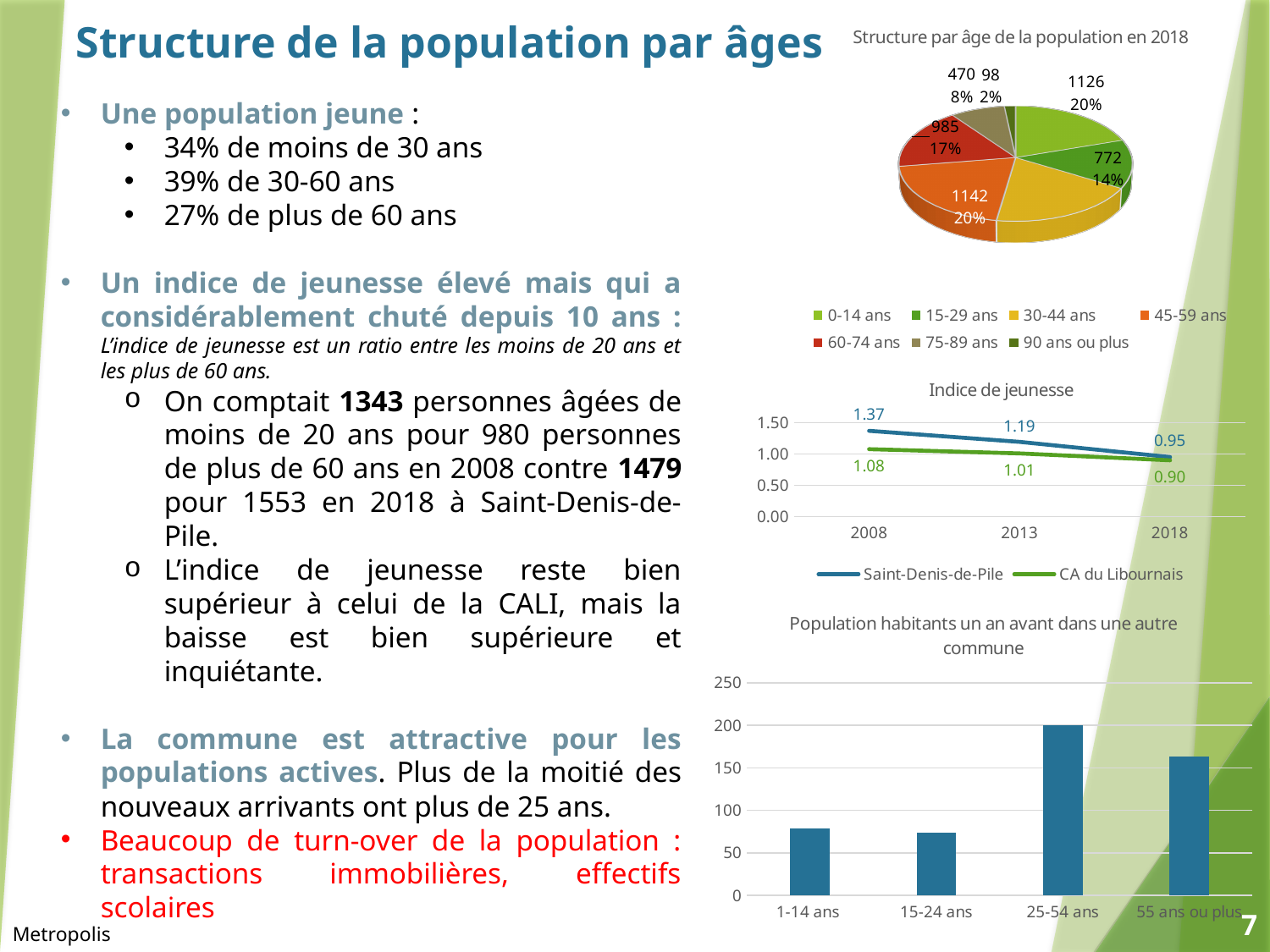
In the 'Indice de jeunesse' chart, do the values for Saint-Denis-de-Pile rise or fall from 2008 to 2018? fall How many age groups does the legend of the pie chart 'Structure par âge de la population en 2018' list? 7 What kind of chart is 'Population habitants un an avant dans une autre commune'? bar chart In the 'Indice de jeunesse' chart, what is the value for CA du Libournais in 2018? 0.90 In the pie chart 'Structure par âge de la population en 2018', what percentage is shown for the 15-29 ans slice? 14% In the 'Indice de jeunesse' chart, what is the value for Saint-Denis-de-Pile in 2008? 1.37 In the chart 'Population habitants un an avant dans une autre commune', is the value for 25-54 ans greater or less than 150? greater In the pie chart 'Structure par âge de la population en 2018', what percentage is shown for the 60-74 ans slice? 17% In the 'Indice de jeunesse' chart, what is the difference between Saint-Denis-de-Pile and CA du Libournais in 2013? 0.18 In the pie chart 'Structure par âge de la population en 2018', which age group has the smallest slice? 90 ans ou plus How many series does the legend of the 'Indice de jeunesse' chart list? 2 In the pie chart 'Structure par âge de la population en 2018', what value is shown for the 0-14 ans slice? 1126